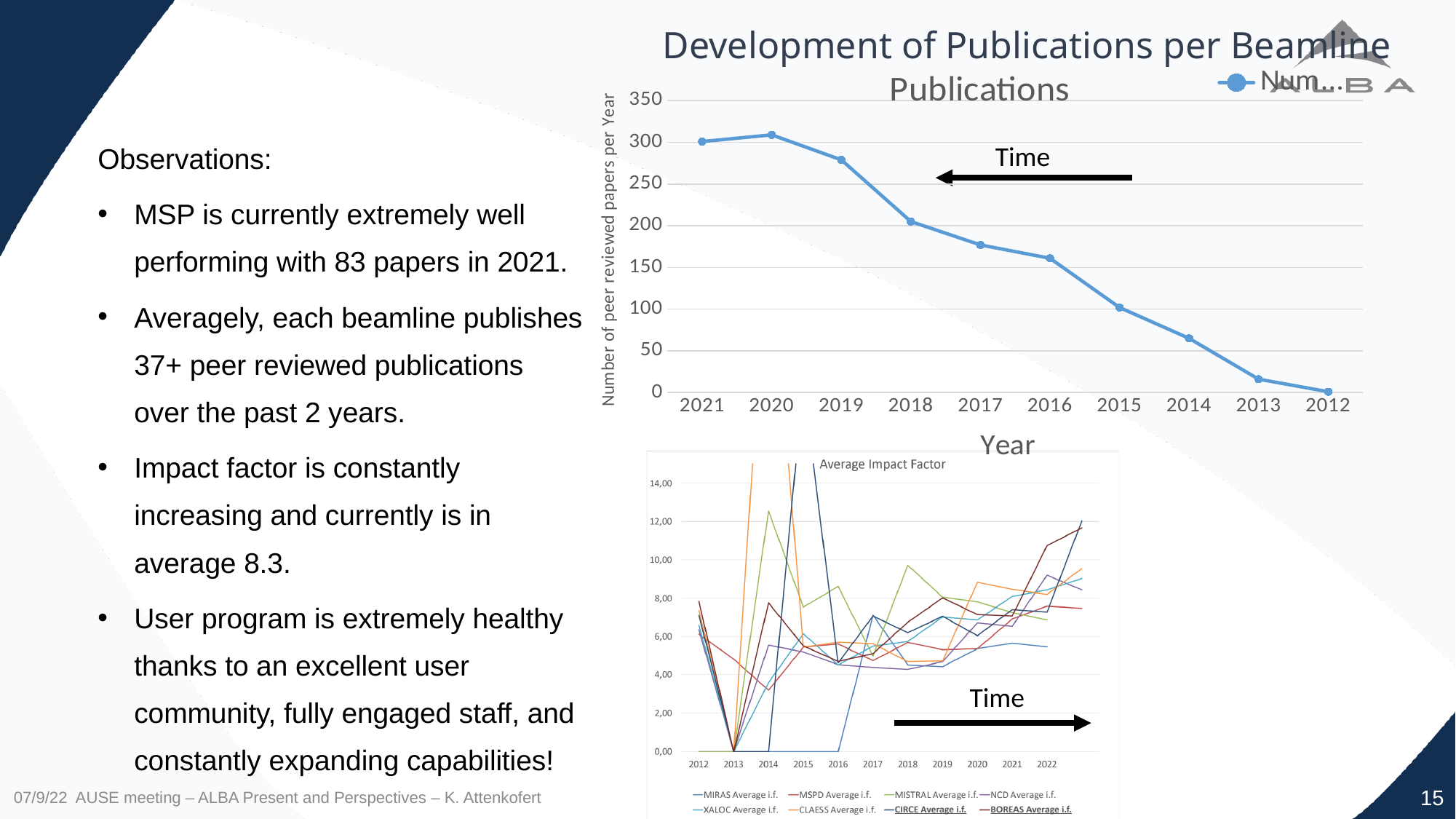
What is the y-axis title of the Publications chart? Number of peer reviewed papers per Year How many series does the legend of the Average Impact Factor chart list? 8 In the Publications chart, do the values rise or fall moving from left to right along the x axis (from 2021 to 2012)? fall In the Publications chart, is the value for 2014 greater or less than 100? less In the Publications chart, is the value for 2013 greater or less than 50? less In the Publications chart, which year has more publications, 2019 or 2016? 2019 In the Publications chart, is the value for 2017 greater or less than 200? less What kind of chart is the Publications chart at the top of the slide? line chart How many years are plotted on the x axis of the Publications chart? 10 How many years are shown on the x axis of the Average Impact Factor chart? 11 In the Publications chart, which year has the lowest number of publications? 2012